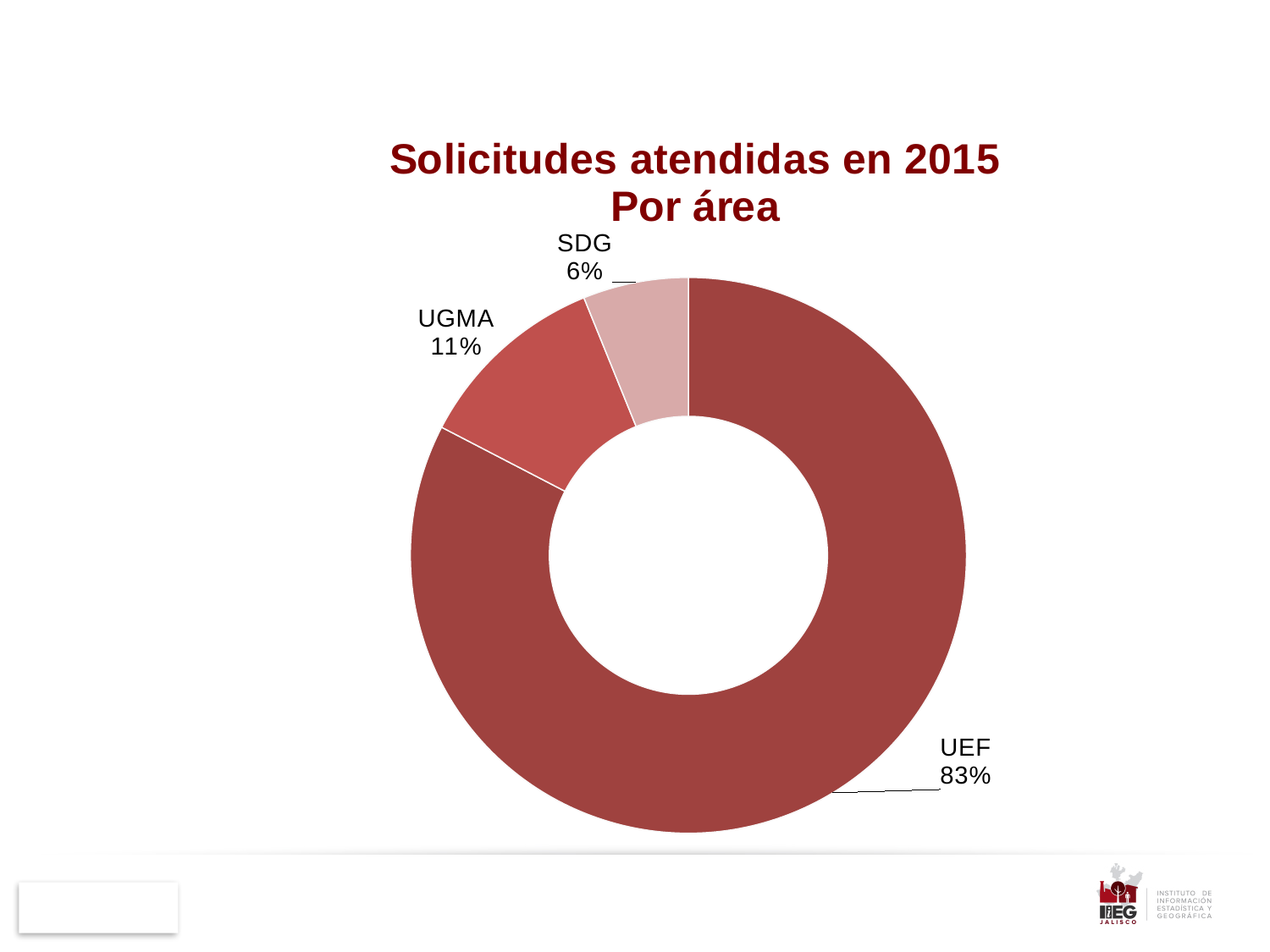
Which area has the largest share of solicitudes atendidas en 2015? UEF What share of the donut chart does UEF account for? 83% What is the difference in percentage points between UEF and UGMA? 72 What is the difference in percentage points between UGMA and SDG? 5 Which has a larger share, UGMA or SDG? UGMA What kind of chart is shown on the slide? Donut (pie) chart What is the title of the chart? Solicitudes atendidas en 2015 Por área How many areas are shown in the chart? 3 What percentage is shown for UGMA? 11% Which area's slice is the lightest in colour? SDG What percentage is shown for SDG? 6% Which area has the smallest share of solicitudes atendidas en 2015? SDG